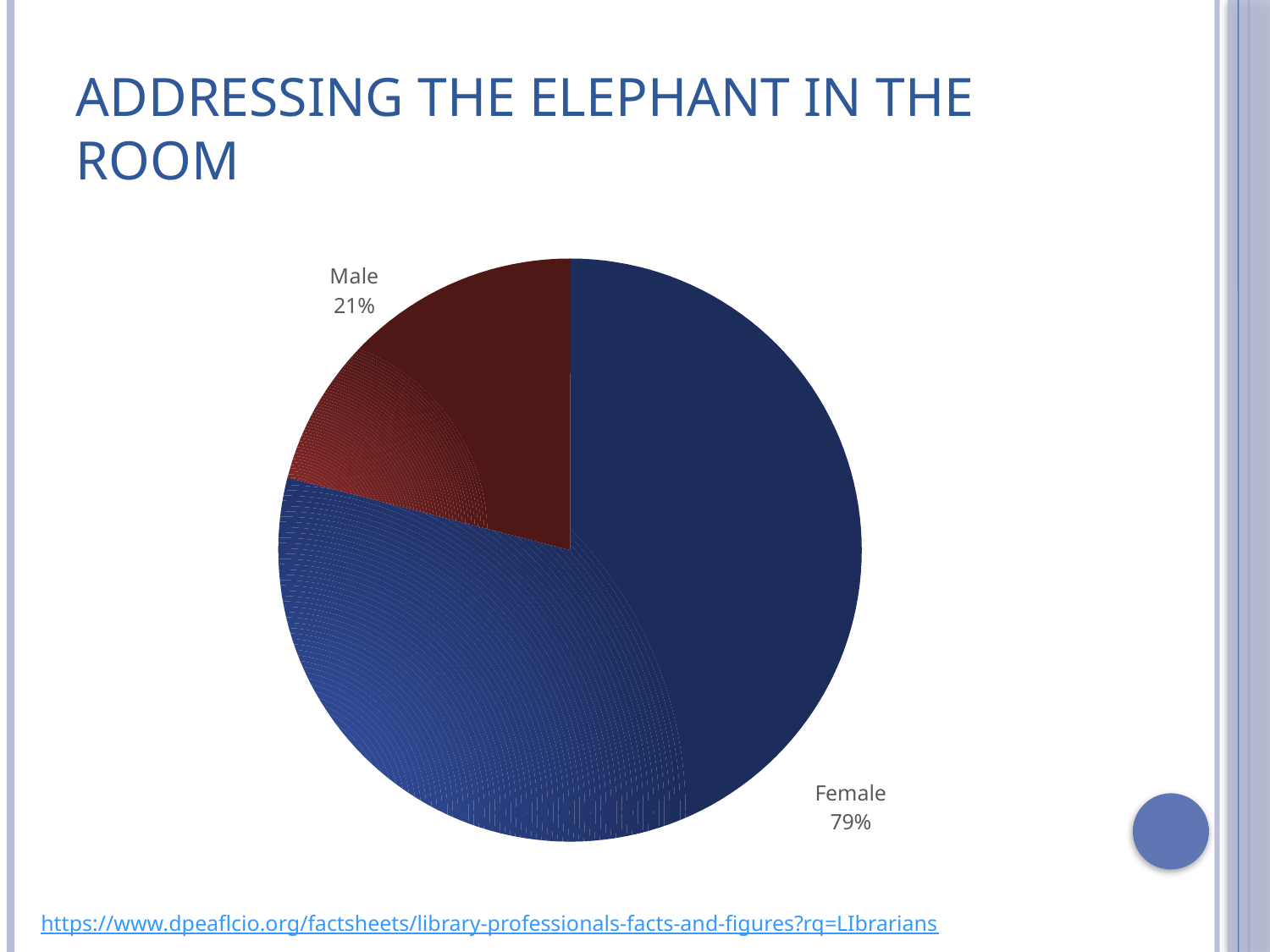
What share of the pie does the Male slice represent? 21% Which slice of the pie is the largest? Female What percentage of the pie is labelled Female? 79% What colour is the Male slice of the pie? dark red What kind of chart is shown on the slide? pie chart What percentage of the pie is labelled Male? 21% What is the difference in percentage points between the Female and Male slices? 58 Which slice of the pie is the smallest? Male Which is larger, the Female slice or the Male slice? Female How many slices does the pie chart have? 2 What is the title of the slide containing the pie chart? ADDRESSING THE ELEPHANT IN THE ROOM